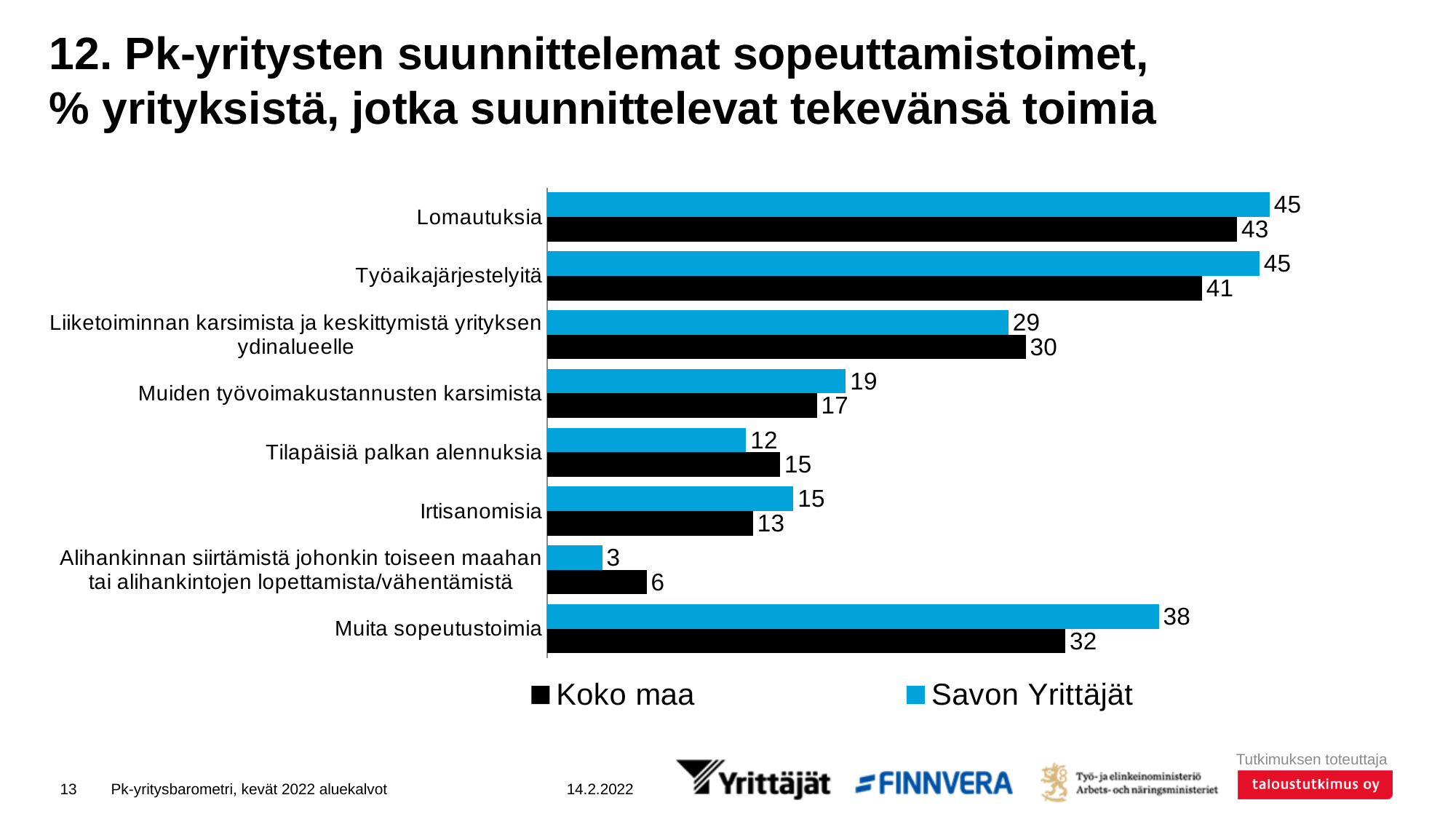
Which category has the lowest value for Savon Yrittäjät? Alihankinnan siirtämistä johonkin toiseen maahan tai alihankintojen lopettamista/vähentämistä Which category has the highest value for Koko maa? Lomautuksia What is the difference between Koko maa and Savon Yrittäjät for Työaikajärjestelyitä? 4 What is the difference between Savon Yrittäjät and Koko maa for Muita sopeutustoimia? 6 What is the value for Koko maa for Työaikajärjestelyitä? 41 What is the value for Koko maa for Muita sopeutustoimia? 32 How many series does the legend list? 2 How many categories are shown in the chart? 8 What is the value for Savon Yrittäjät for Lomautuksia? 45 What kind of chart is shown on the slide? Bar chart For Irtisanomisia, which series has the larger value, Koko maa or Savon Yrittäjät? Savon Yrittäjät What is the value for Savon Yrittäjät for Tilapäisiä palkan alennuksia? 12